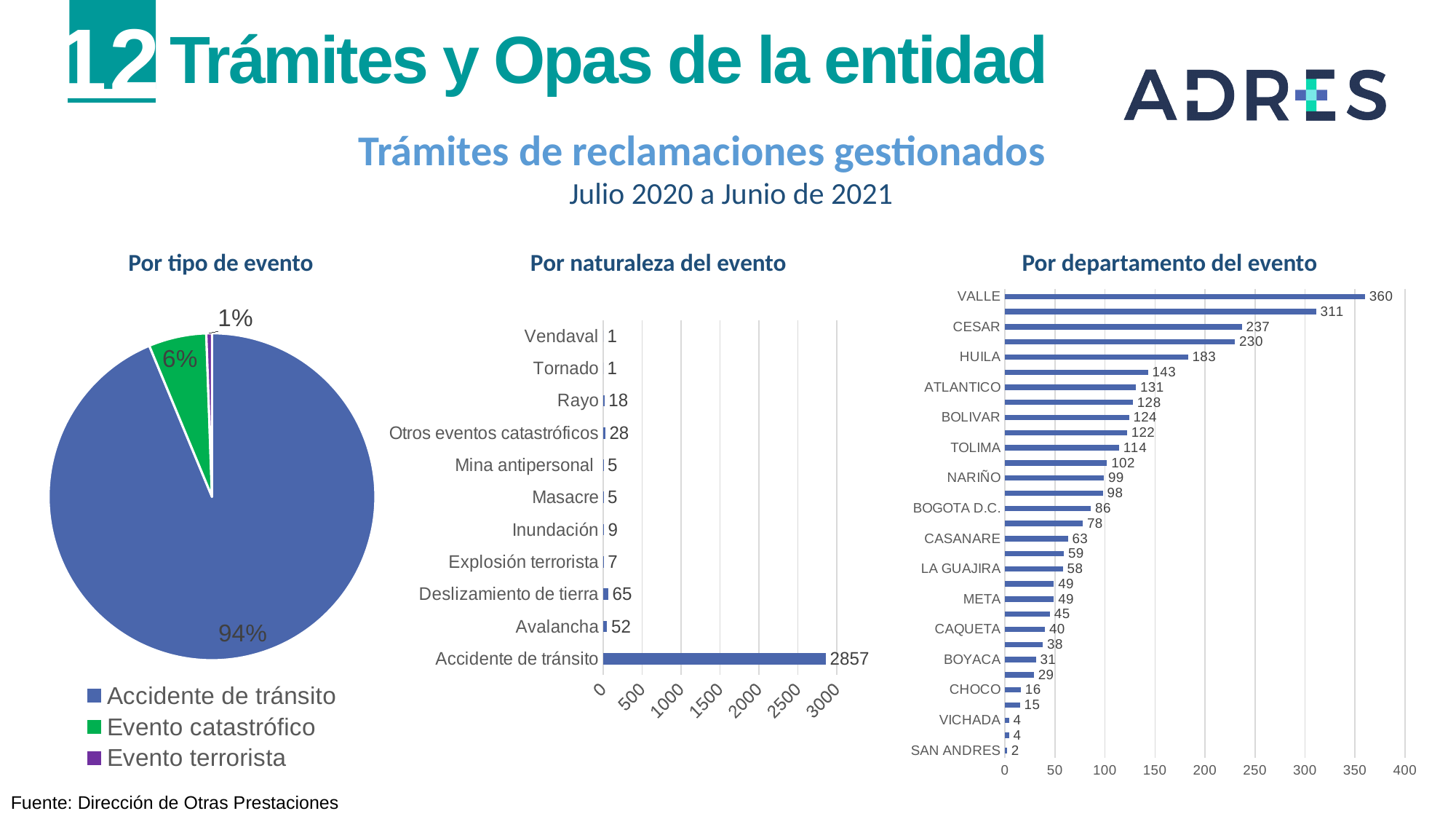
In the 'Por departamento del evento' chart, which is larger, BOLIVAR or TOLIMA? BOLIVAR How many entries does the legend of the 'Por tipo de evento' pie chart list? 3 In the 'Por naturaleza del evento' chart, what is the value for Deslizamiento de tierra? 65 In the 'Por departamento del evento' chart, which department has the highest value? VALLE In the 'Por departamento del evento' chart, what is the value for HUILA? 183 In the 'Por tipo de evento' pie chart, what share is Evento catastrófico? 6% In the 'Por departamento del evento' chart, what is the difference between VALLE and CESAR? 123 What kind of chart is 'Por naturaleza del evento'? Bar chart In the 'Por naturaleza del evento' chart, what is the difference between Deslizamiento de tierra and Avalancha? 13 In the 'Por naturaleza del evento' chart, what is the value for Accidente de tránsito? 2857 How many categories are shown in the 'Por naturaleza del evento' chart? 11 In the 'Por tipo de evento' pie chart, what share is Accidente de tránsito? 94%